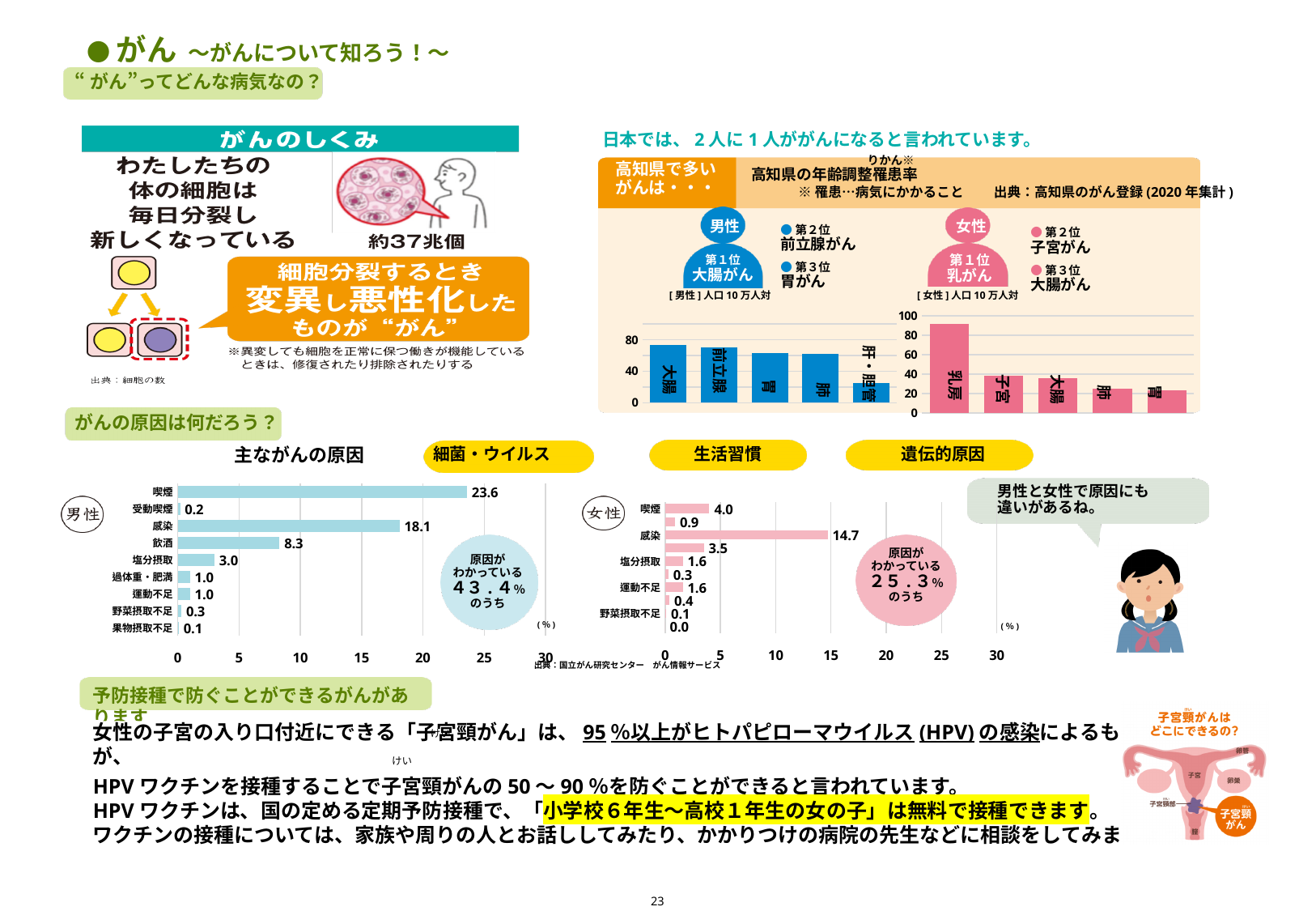
In the female chart of 主ながんの原因, which category has the highest value? 感染 In the female chart of 主ながんの原因, what is the value for 喫煙? 4.0 In the male chart of 主ながんの原因, which category has the highest value? 喫煙 In the male chart of 主ながんの原因, what is the value for 喫煙? 23.6 In the male chart of 主ながんの原因, what is the value for 感染? 18.1 In the male chart of 主ながんの原因, how many categories are listed? 9 In the female chart of 主ながんの原因, what is the value for 感染? 14.7 In the 高知県の年齢調整罹患率 female chart, is the value for 乳房 greater or less than 80? greater What kind of chart is the male 主ながんの原因 chart? bar chart In the male chart of 主ながんの原因, what is the value for 飲酒? 8.3 In the male chart of 主ながんの原因, what is the difference between 喫煙 and 感染? 5.5 In the 高知県の年齢調整罹患率 male chart, is the value for 肝・胆管 greater or less than 40? less